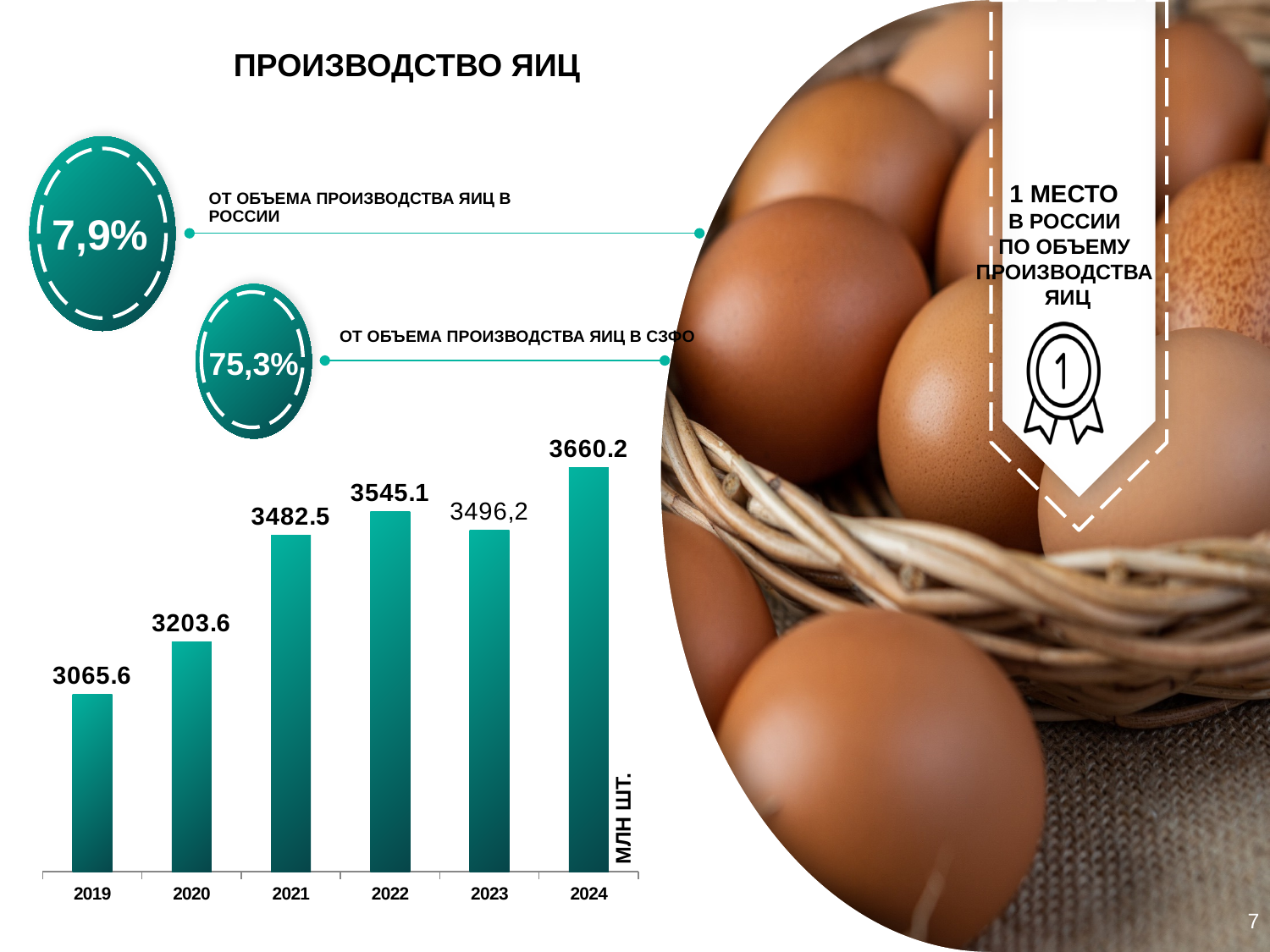
How many years are shown on the x axis of the chart? 6 What unit is indicated on the chart's vertical axis label? МЛН ШТ. What is the egg production value shown for 2024? 3660.2 Which year has the highest egg production in the chart? 2024 What is the egg production value shown for 2019? 3065.6 What value is labelled on the bar for 2023? 3496,2 Which year has the larger value, 2022 or 2023? 2022 What is the value shown for 2021? 3482.5 What is the difference between the 2020 and 2019 values? 138.0 What type of chart is used to show egg production? bar chart Which year has the lowest egg production in the chart? 2019 By how much did egg production increase from 2019 to 2024? 594.6